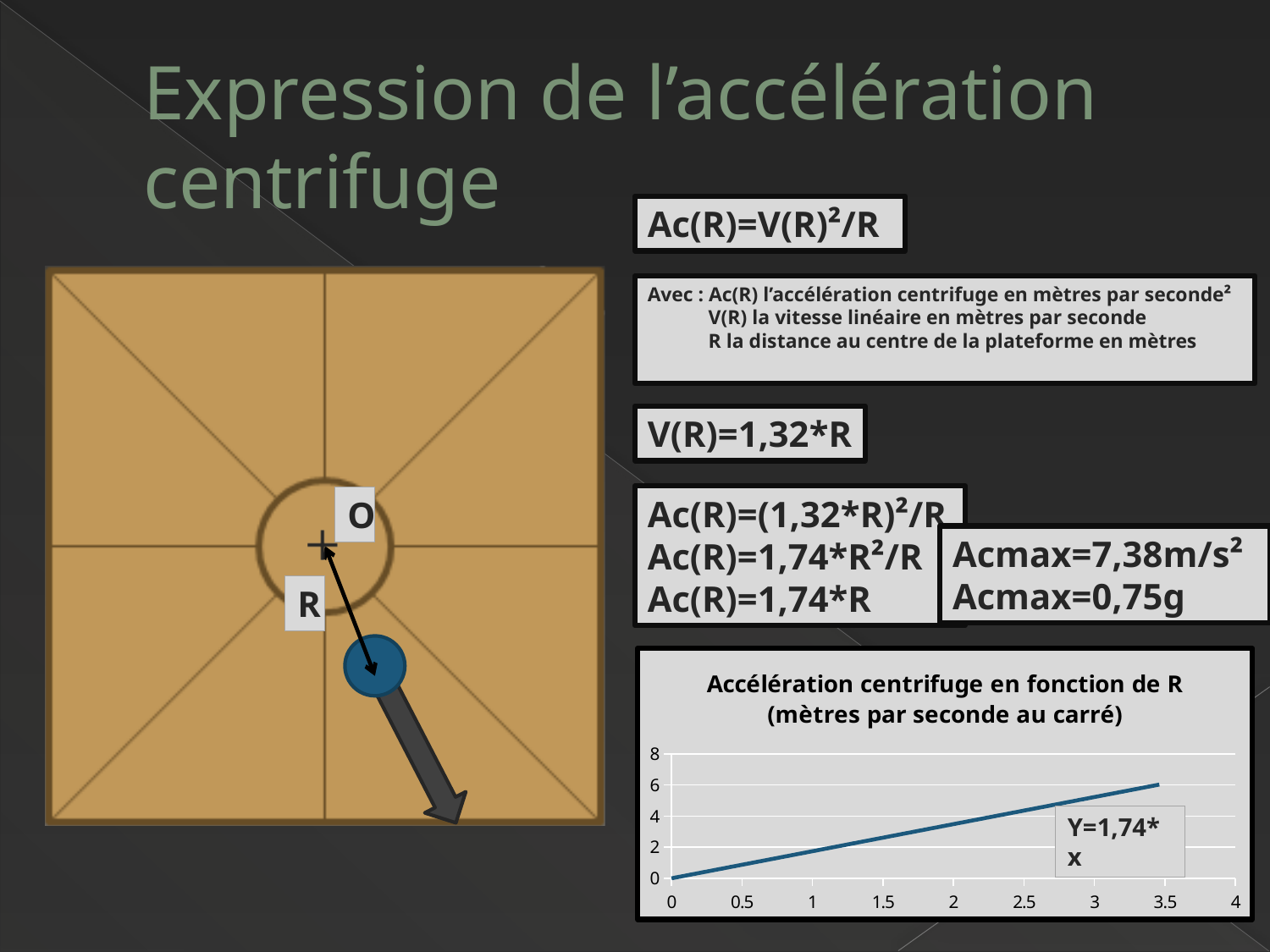
Is the value of the line at R = 3.5 greater or less than 8? less What is the title of the chart? Accélération centrifuge en fonction de R (mètres par seconde au carré) Is the value of the line at R = 2 greater or less than 4? less Does the plotted line rise or fall as R increases along the x axis? rise What kind of chart is shown on the slide? line chart What equation is written as a label on the chart? Y=1,74*x Which is larger, the value of the line at R = 1 or at R = 3? R = 3 What is the value of the line at R = 0? 0 Is the value of the line at R = 2.5 greater or less than 2? greater